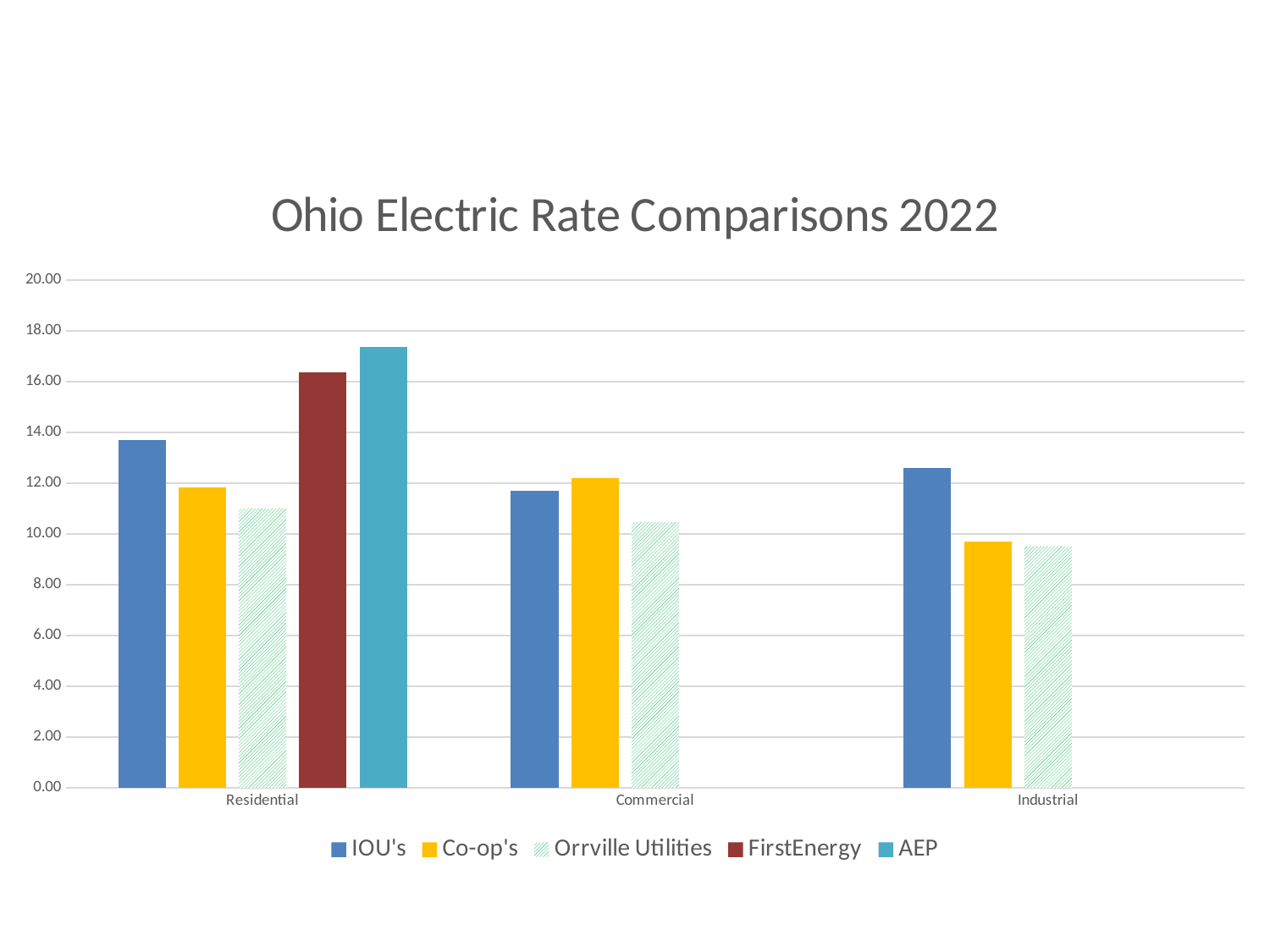
Is the value for Orrville Utilities in the Commercial category greater or less than 12.00? less Is the value for FirstEnergy in the Residential category greater or less than 14.00? greater How many series does the legend list? 5 What is the title of the chart? Ohio Electric Rate Comparisons 2022 Which series has the highest value in the Commercial category? Co-op's Which series has the highest value in the Industrial category? IOU's How many categories are shown on the x axis? 3 Which series has the lowest value in the Residential category? Orrville Utilities What kind of chart is shown on the slide? bar chart In the Residential category, which is larger: IOU's or Co-op's? IOU's Is the value for AEP in the Residential category greater or less than 16.00? greater Which series has the highest value in the Residential category? AEP